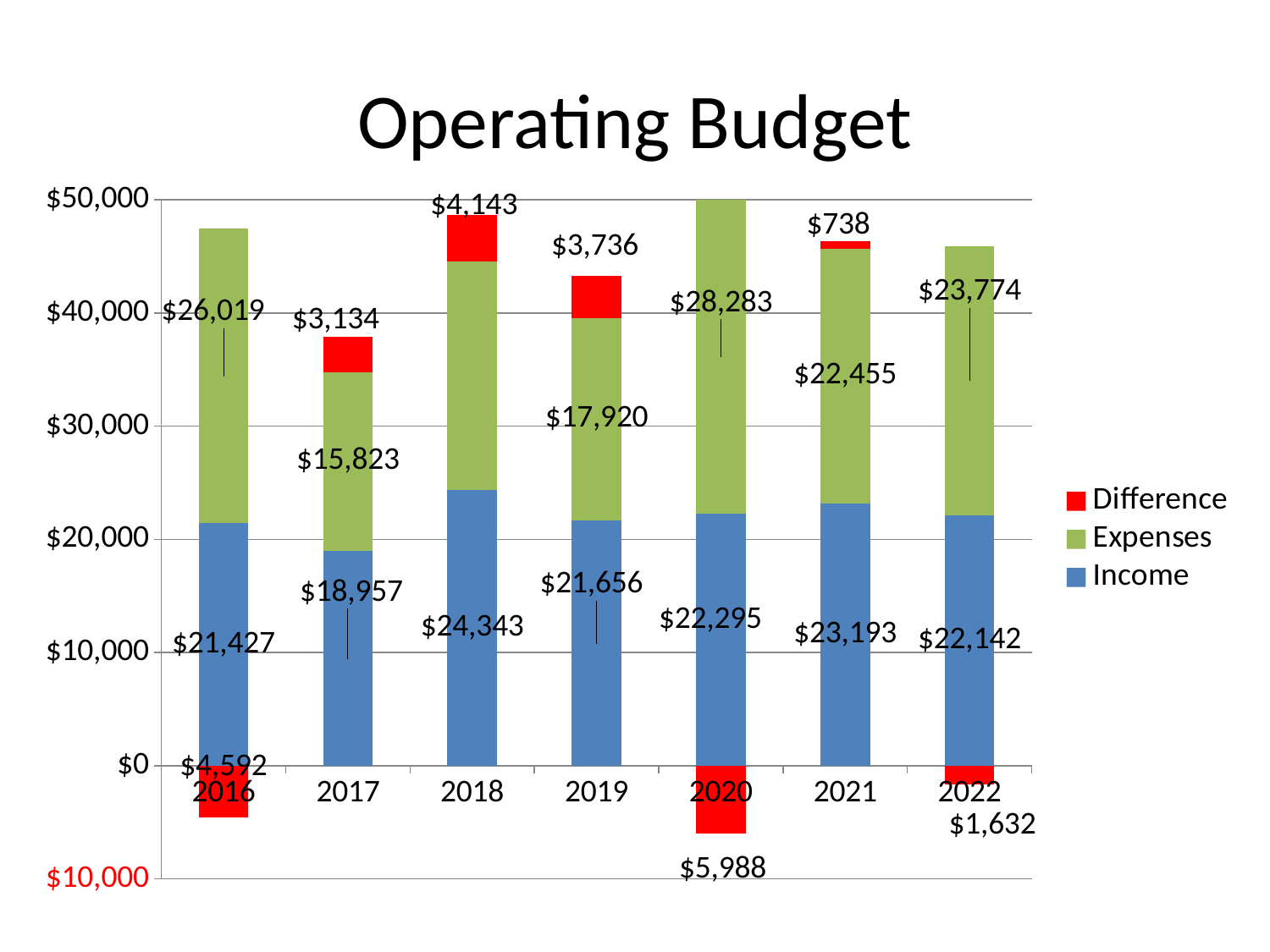
What type of chart is shown on the slide? Stacked bar chart Which is larger in 2022, Income or Expenses? Expenses How many years are shown on the x axis? 7 What is the Difference value for 2021? $738 How many series does the legend list? 3 What is the difference between Expenses and Income in 2019? $3,736 What is the title of the chart? Operating Budget Which year has the highest Income? 2018 Which year has the lowest Income? 2017 What is the Income value for 2016? $21,427 What is the Expenses value for 2020? $28,283 Which year has the highest Expenses value among the labelled values? 2020